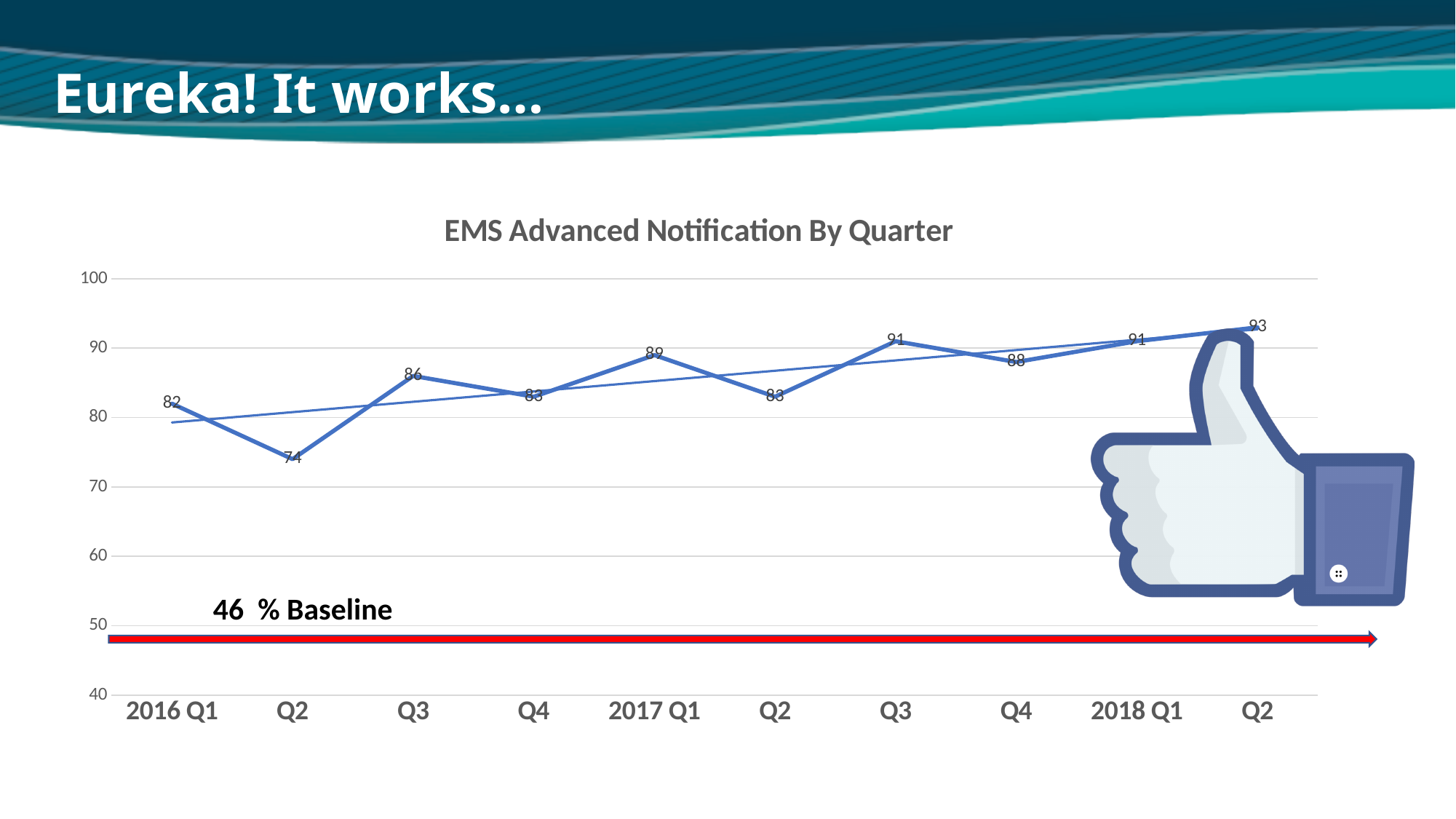
What is the value for 2018 Q2? 93 What is the value for 2016 Q2? 74 What is the difference between the values for 2018 Q2 and 2016 Q1? 11 What is the title of the chart? EMS Advanced Notification By Quarter What is the value for 2016 Q1? 82 How many quarters are plotted on the chart? 10 Which quarter has the lowest value? 2016 Q2 What is the value for 2017 Q1? 89 Which is larger, the value for 2017 Q3 or the value for 2017 Q4? 2017 Q3 Which quarter has the highest value? 2018 Q2 Overall, do the values rise or fall from 2016 Q1 to 2018 Q2? rise What kind of chart is shown on the slide? line chart